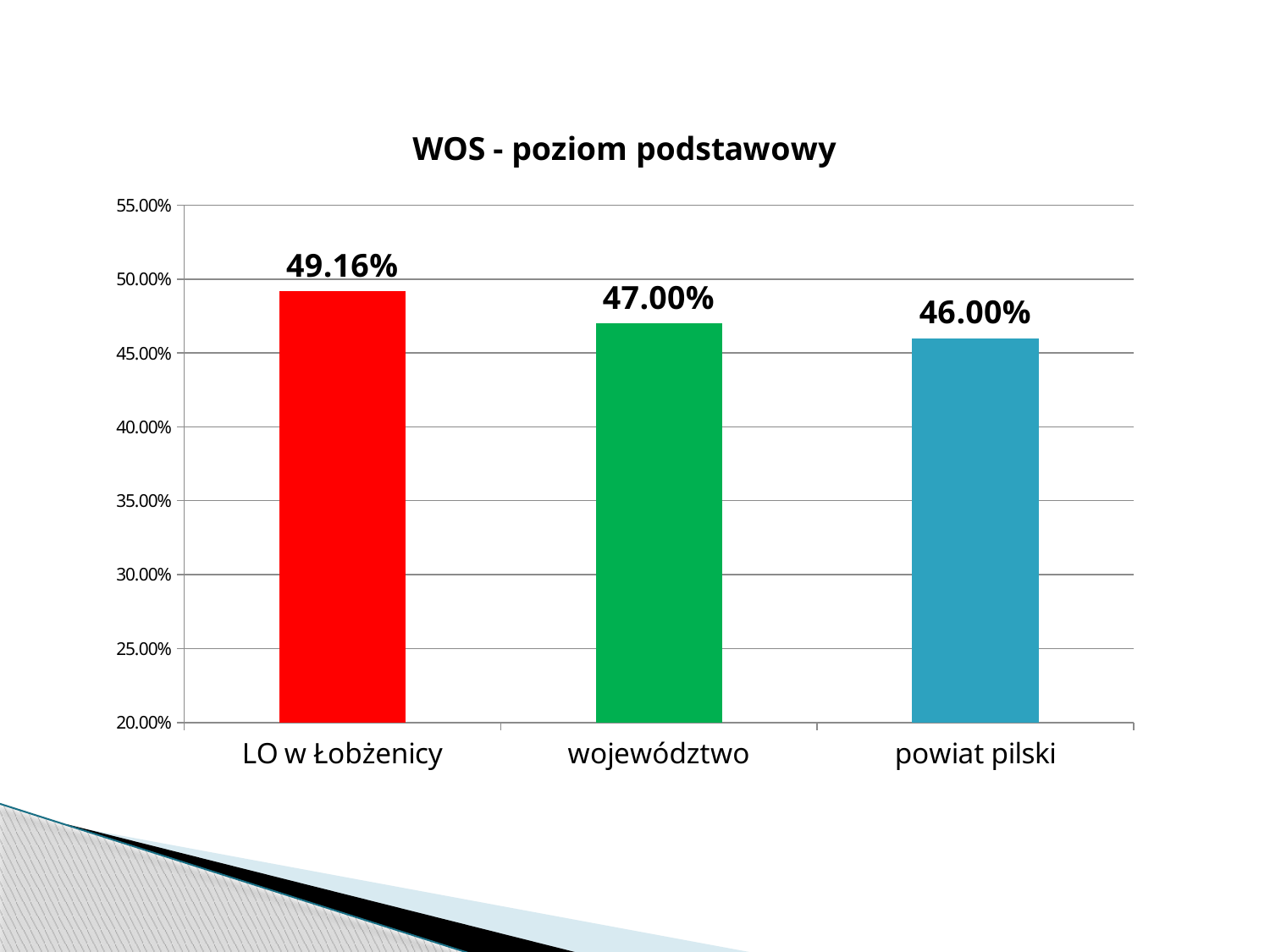
How many categories are shown in the chart? 3 Which category has the highest value? LO w Łobżenicy What is the difference between the values for LO w Łobżenicy and powiat pilski? 3.16% Which is larger, the value for LO w Łobżenicy or the value for województwo? LO w Łobżenicy What is the value for województwo? 47.00% What kind of chart is shown on the slide? bar chart What is the title of the chart? WOS - poziom podstawowy Which category has the lowest value? powiat pilski Is the value for LO w Łobżenicy greater or less than 50.00%? less What is the difference between the values for województwo and powiat pilski? 1.00% What is the value for powiat pilski? 46.00% What is the value for LO w Łobżenicy? 49.16%